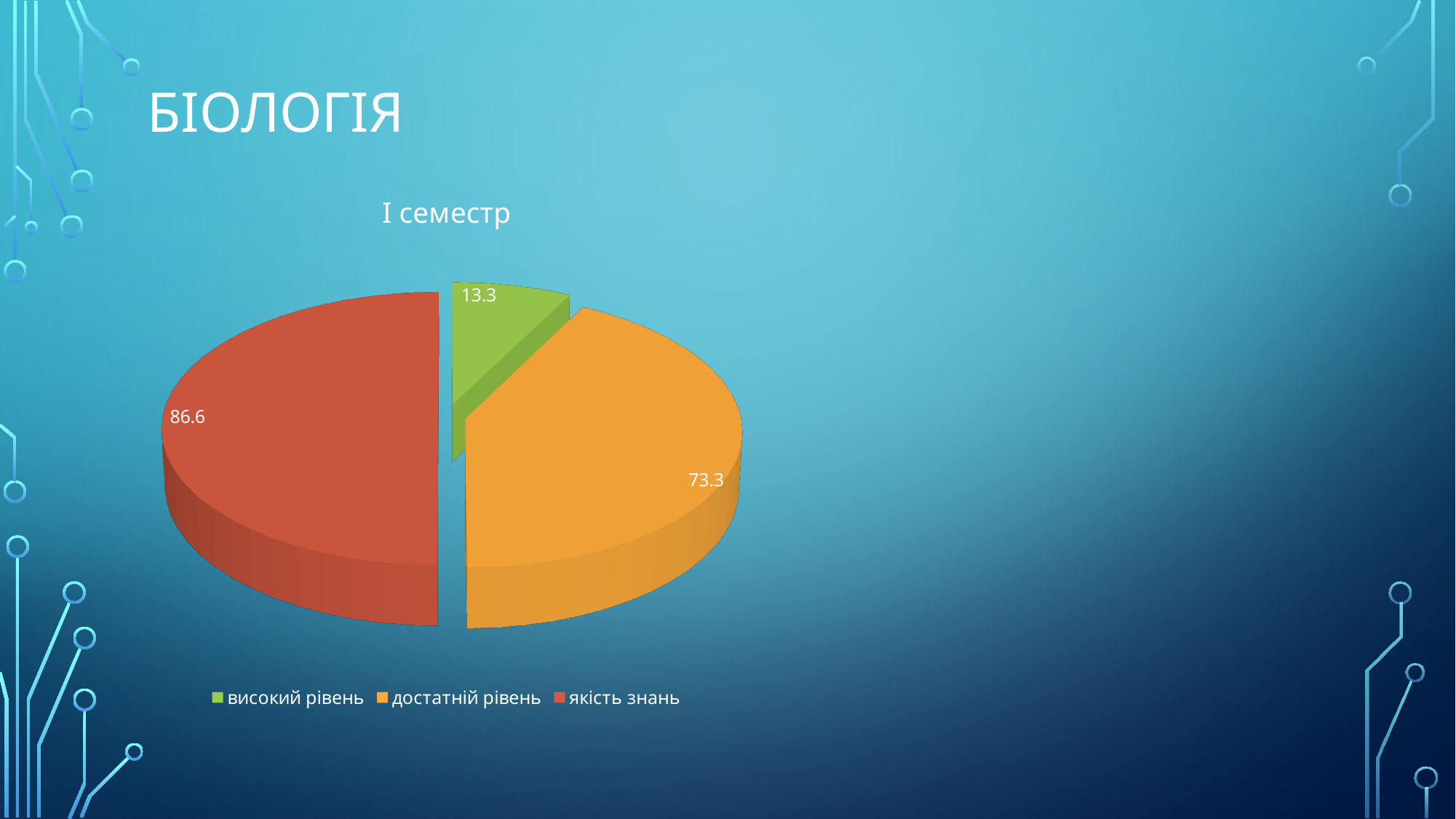
What type of chart is shown on the slide? pie chart What value is shown for високий рівень? 13.3 Which is larger, the value for достатній рівень or the value for високий рівень? достатній рівень What value is shown for якість знань? 86.6 What value is shown for достатній рівень? 73.3 How many slices does the pie chart have? 3 What colour is the slice for якість знань? red Which category has the largest slice? якість знань Which category has the smallest slice? високий рівень What is the title of the chart? І семестр What is the difference between the values for якість знань and достатній рівень? 13.3 What is the difference between the values for достатній рівень and високий рівень? 60